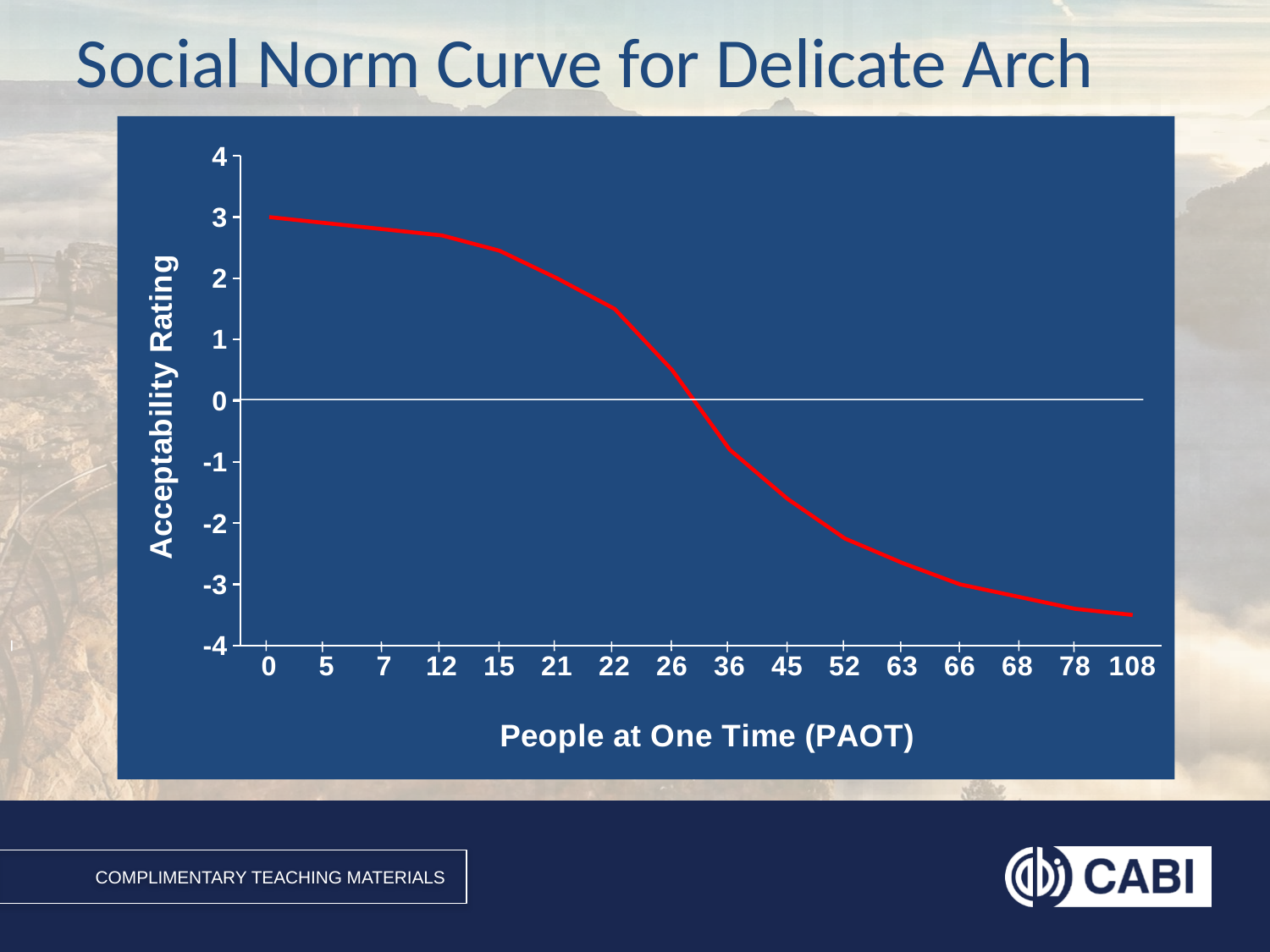
How many PAOT categories are shown on the x axis? 16 Which has the higher acceptability rating, 12 PAOT or 63 PAOT? 12 What kind of chart is shown on the slide? line chart What is the label of the y axis? Acceptability Rating At which PAOT value is the acceptability rating highest? 0 What is the title of the chart? Social Norm Curve for Delicate Arch Is the acceptability rating at 36 PAOT greater or less than 0? less Is the acceptability rating at 22 PAOT greater or less than 1? greater Does the acceptability rating rise or fall as People at One Time increases? fall Is the acceptability rating at 15 PAOT greater or less than 2? greater At which PAOT value is the acceptability rating lowest? 108